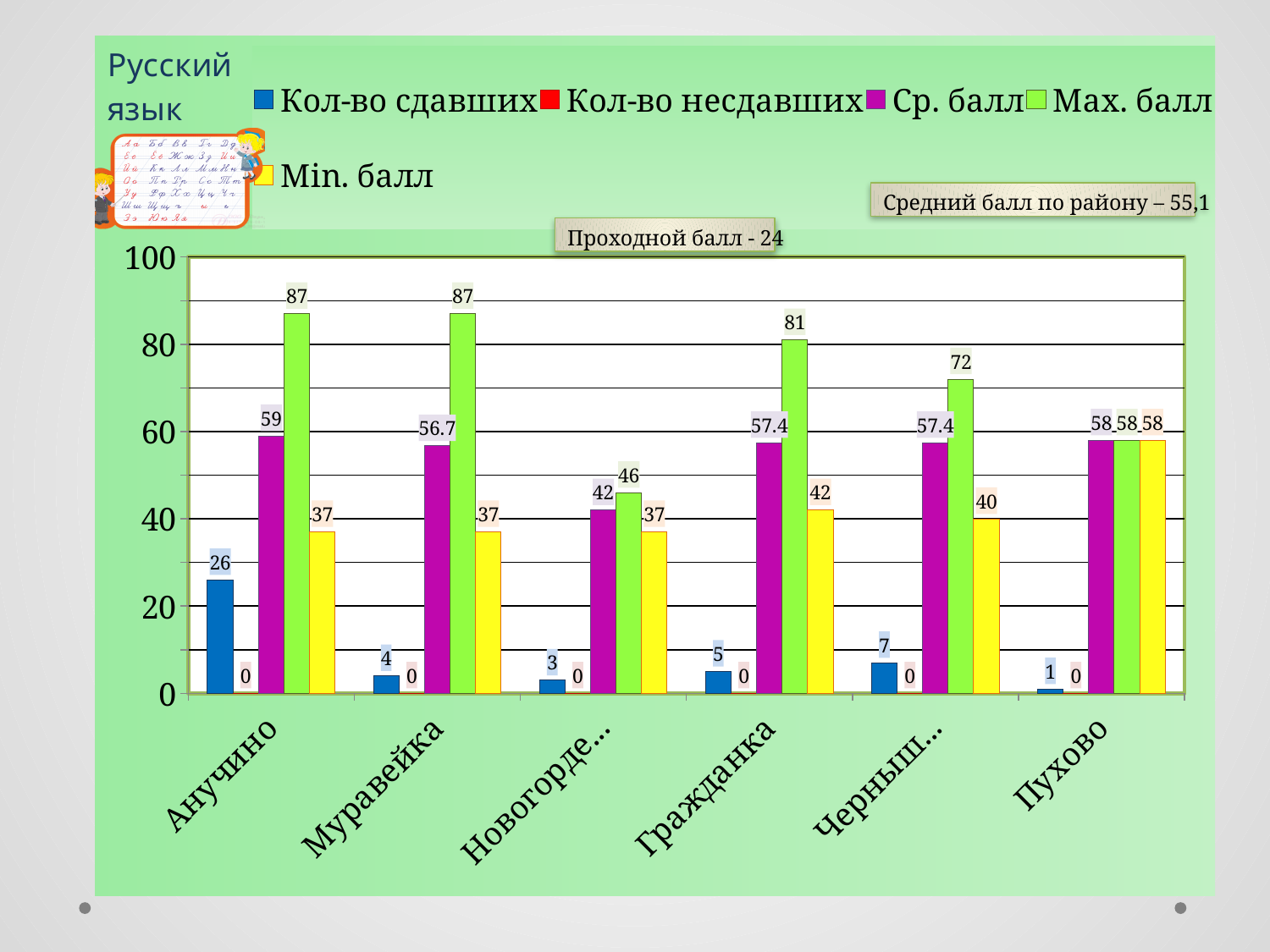
What is the Ср. балл value for Муравейка? 56.7 Which category has the highest Кол-во сдавших value? Анучино What is the difference between the Max. балл and Min. балл values for Анучино? 50 Which category has the lowest Кол-во сдавших value? Пухово What is the Min. балл value for Пухово? 58 Which has the larger Ср. балл value, Анучино or Пухово? Анучино How many series does the chart legend list? 5 What kind of chart is shown on the slide? bar chart How many categories are shown on the x axis of the chart? 6 What is the Max. балл value for Гражданка? 81 What is the value of Кол-во сдавших for Анучино? 26 What is the difference between the Max. балл values for Муравейка and Гражданка? 6